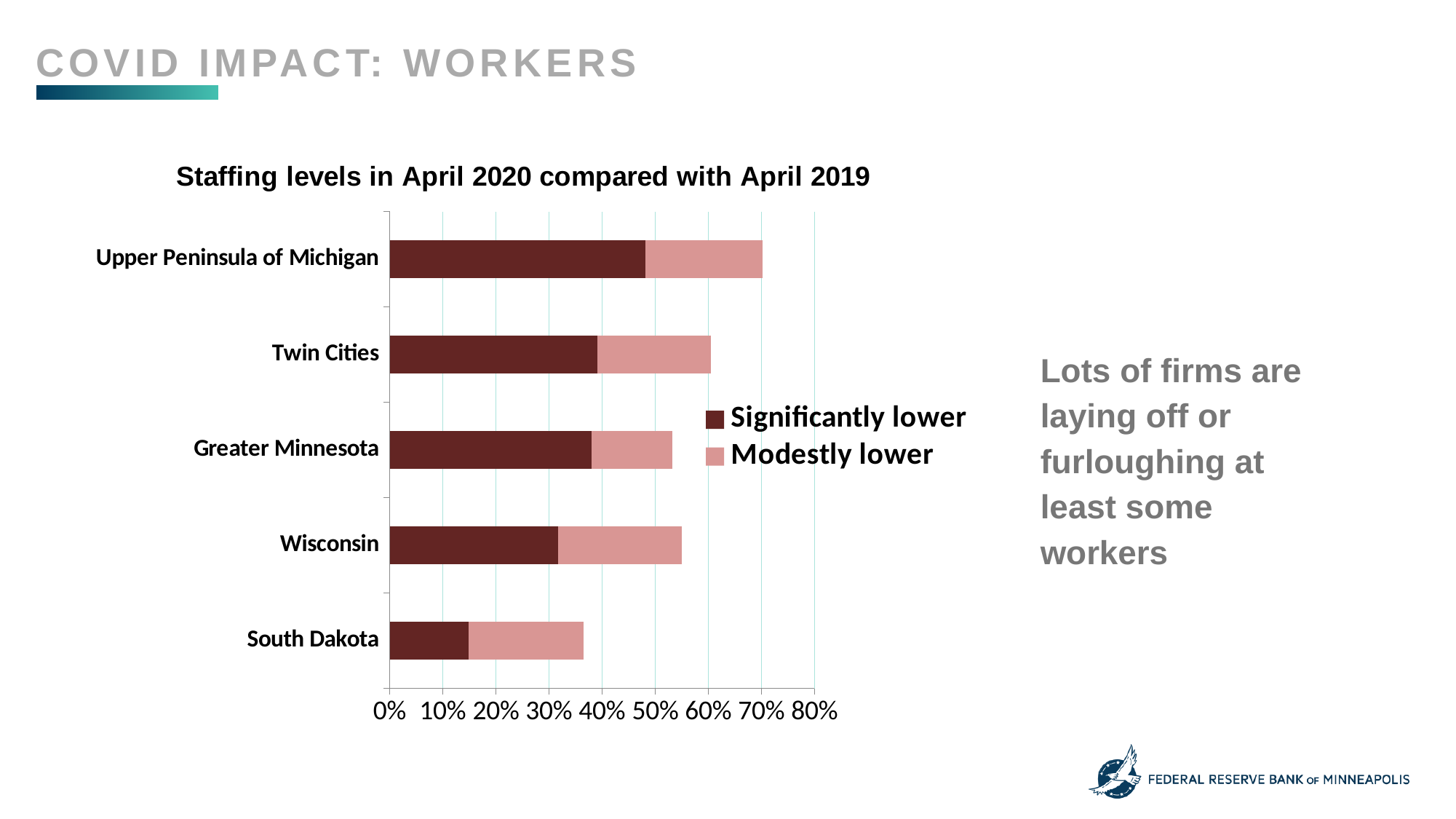
Which region has the shortest total bar? South Dakota Which region has the largest 'Significantly lower' share? Upper Peninsula of Michigan Is the total bar for Twin Cities greater or less than 50%? greater Which region has the smallest 'Significantly lower' share? South Dakota Is the 'Significantly lower' value for South Dakota greater or less than 20%? less Which region has the longest total bar? Upper Peninsula of Michigan What is the title of the chart? Staffing levels in April 2020 compared with April 2019 What kind of chart is shown on the slide? Bar chart How many regions are shown on the chart? 5 Is the 'Significantly lower' value for Upper Peninsula of Michigan greater or less than 40%? greater How many series does the legend list? 2 Which has the larger total bar, Twin Cities or South Dakota? Twin Cities